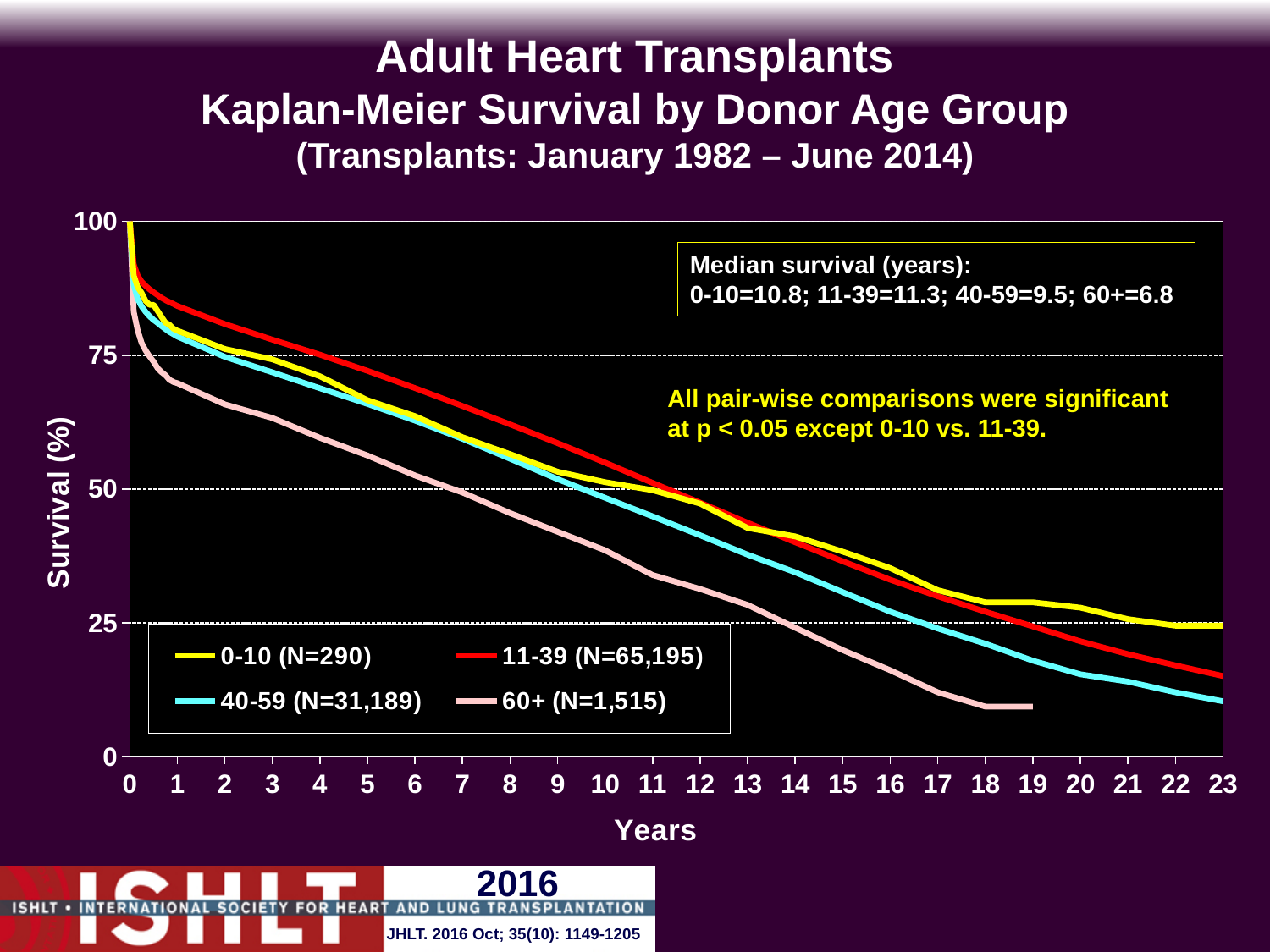
What is the difference in median survival between the 11-39 group and the 60+ group? 4.5 years How many series does the legend list? 4 Do the survival curves rise or fall as the years increase? fall What kind of chart is shown on the slide? line chart Is the survival for the 40-59 group at year 20 greater or less than 25? less Which donor age group has the highest survival at year 5? 11-39 Is the survival for the 60+ group at year 10 greater or less than 50? less Is the survival for the 11-39 group at year 5 greater or less than 50? greater At year 15, which has higher survival: the 11-39 group or the 60+ group? 11-39 What is the label of the y axis? Survival (%) Which donor age group has the lowest survival at year 15? 60+ What is the median survival in years for the 60+ donor age group? 6.8